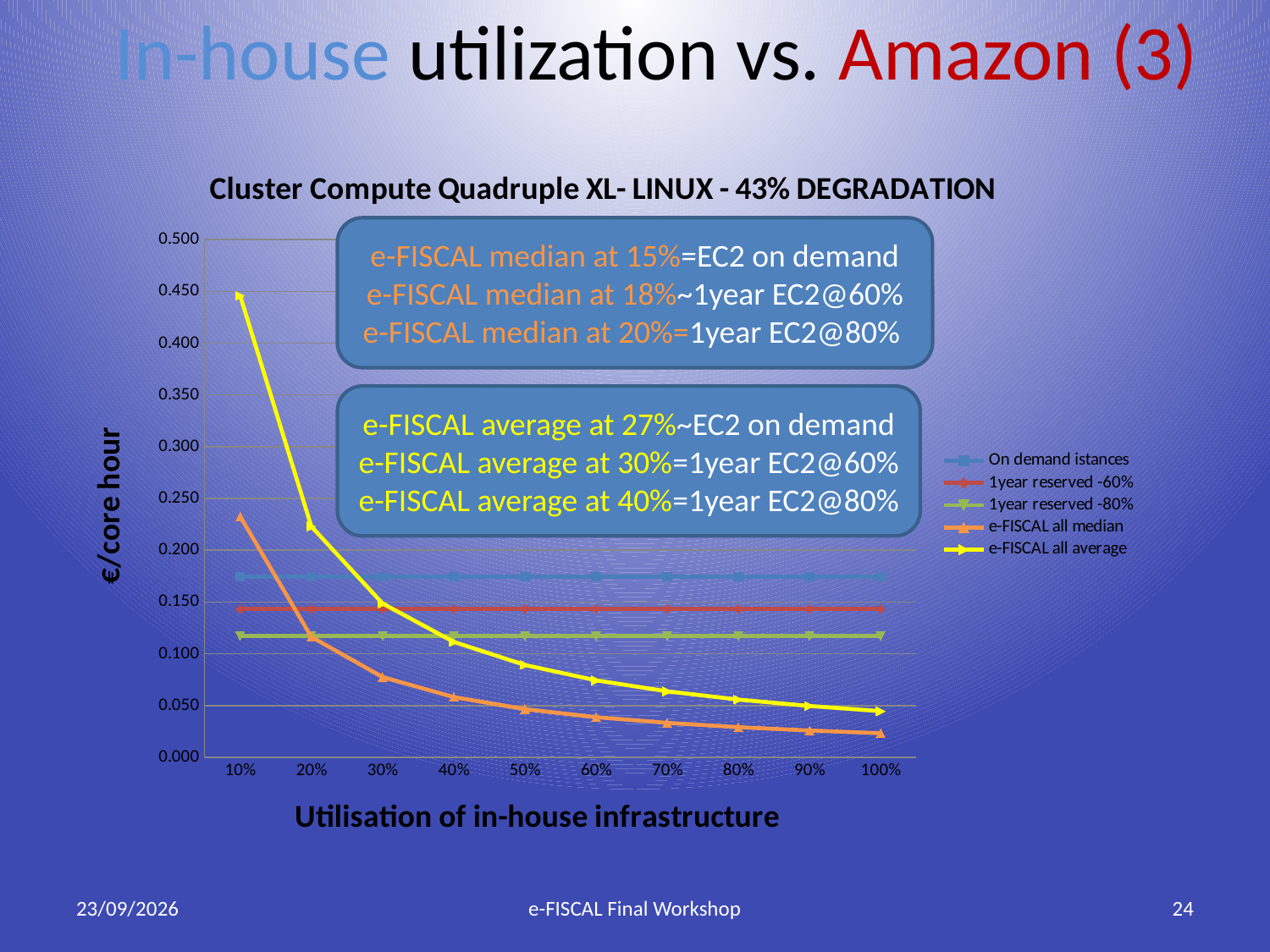
What is the title of the chart? Cluster Compute Quadruple XL- LINUX - 43% DEGRADATION How many utilisation levels are shown along the x axis? 10 How many series does the chart legend list? 5 Is the value for e-FISCAL all median at 10% utilisation greater or less than 0.250? less Does the e-FISCAL all average series rise or fall as utilisation of in-house infrastructure increases? Fall What is the label of the y axis? €/core hour Is the value for e-FISCAL all average at 10% utilisation greater or less than 0.400? greater Is the value for On demand istances greater or less than 0.150? greater Which series has the highest value at 10% utilisation? e-FISCAL all average What kind of chart is shown on the slide? Line chart At 100% utilisation, which is larger: On demand istances or e-FISCAL all median? On demand istances